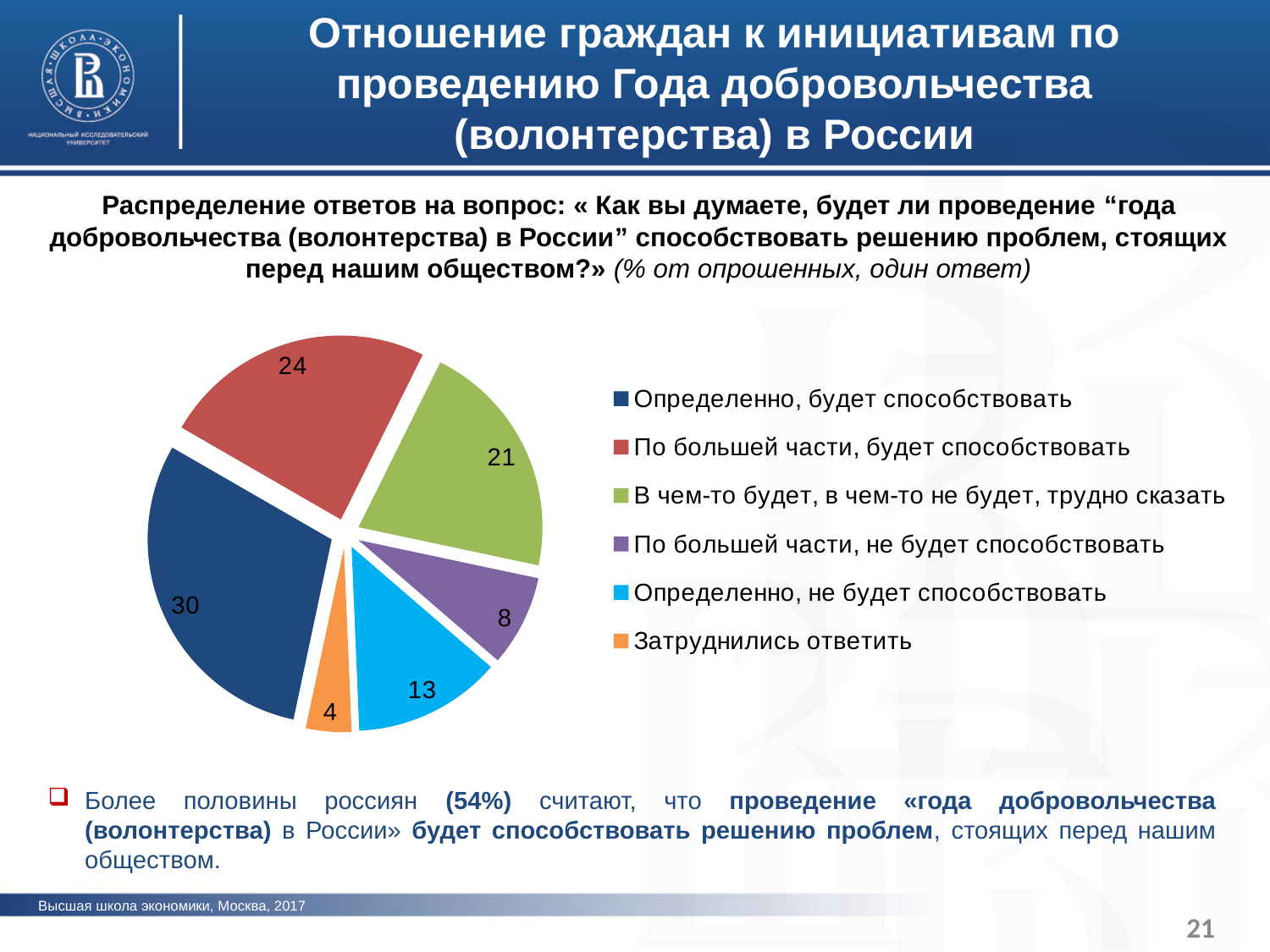
What is the value for "В чем-то будет, в чем-то не будет, трудно сказать"? 21 How many entries does the legend of the pie chart list? 6 How many slices does the pie chart have? 6 What kind of chart is shown on the slide? pie chart Which is larger: the value for "По большей части, будет способствовать" or the value for "В чем-то будет, в чем-то не будет, трудно сказать"? По большей части, будет способствовать What is the value for "Затруднились ответить"? 4 Which answer option has the smallest slice of the pie? Затруднились ответить What is the value for "Определенно, будет способствовать"? 30 What is the value for "По большей части, будет способствовать"? 24 What is the difference between the values for "Определенно, не будет способствовать" and "По большей части, не будет способствовать"? 5 What colour is the slice for "Определенно, не будет способствовать"? light blue Which answer option has the largest slice of the pie? Определенно, будет способствовать